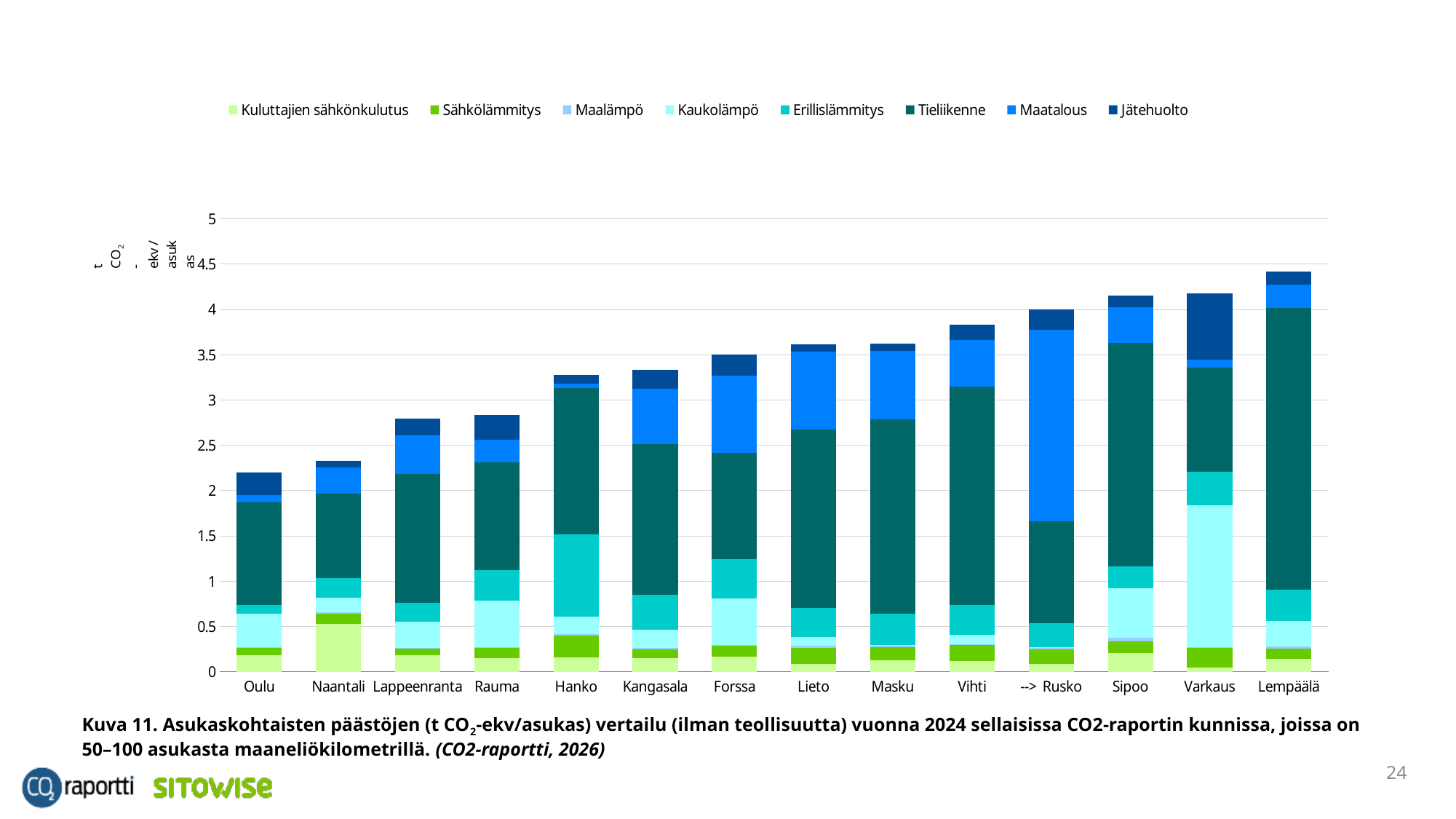
Which municipality has the highest total bar in the chart? Lempäälä How many municipalities are shown on the x axis of the chart? 14 Is the total value for Oulu greater or less than 2.5? less Which municipality has the lowest total bar in the chart? Oulu Is the total value for Hanko greater or less than 3? greater Which series is listed last in the chart legend? Jätehuolto What kind of chart is shown on the slide? stacked bar chart Do the total bar heights generally rise or fall from left to right along the x axis? rise How many series does the legend of the chart list? 8 Is the total value for Lempäälä greater or less than 4? greater Which series is listed first in the chart legend? Kuluttajien sähkönkulutus Which has the larger total bar, Varkaus or Hanko? Varkaus